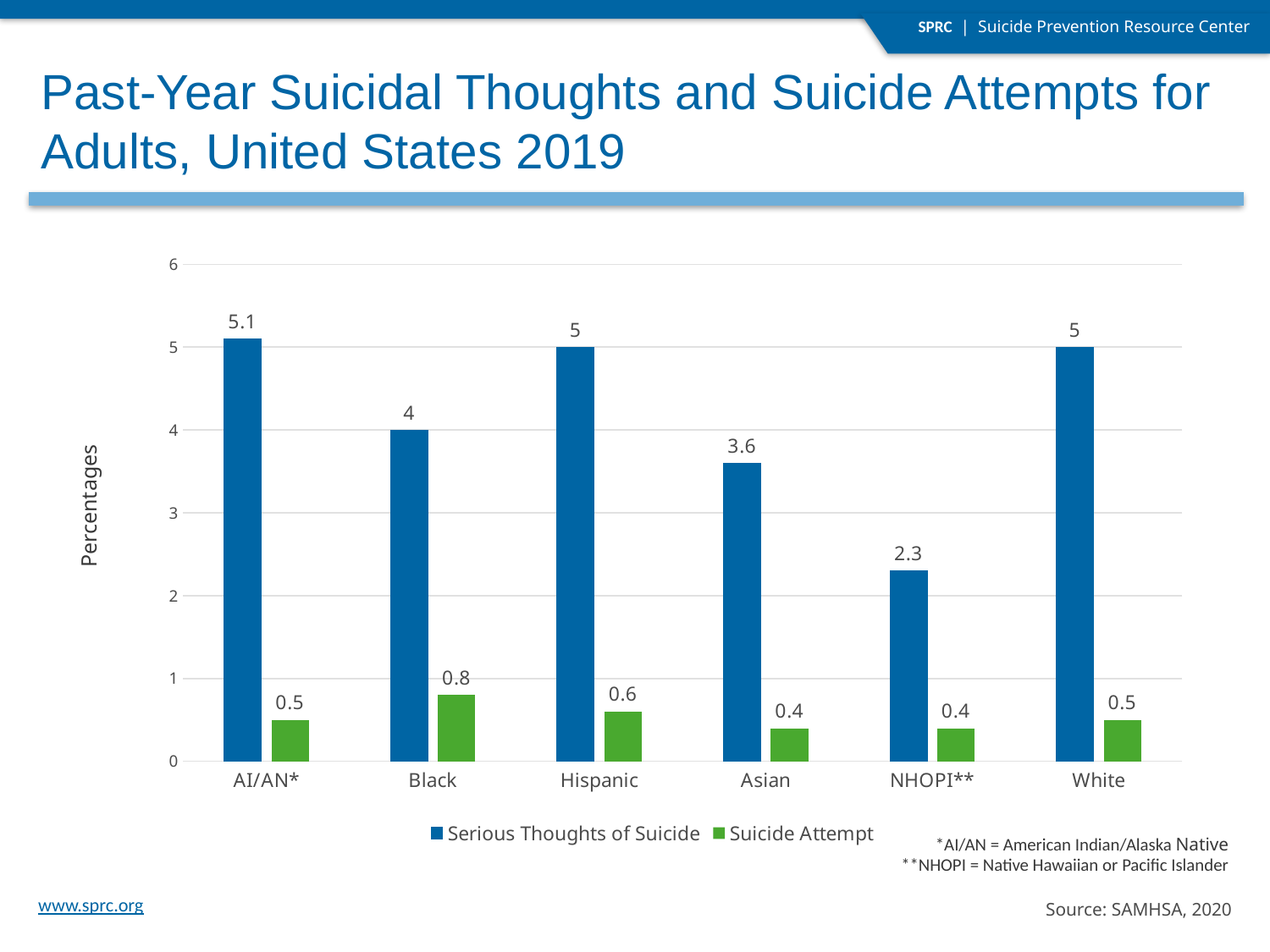
How many categories are shown on the x axis? 6 Which category has the highest value for Serious Thoughts of Suicide? AI/AN* How many series does the legend list? 2 What is the value for Suicide Attempt for Black? 0.8 Which is larger, the Serious Thoughts of Suicide value for Black or for Asian? Black What is the value for Serious Thoughts of Suicide for AI/AN*? 5.1 What is the difference between the Serious Thoughts of Suicide values for Hispanic and Asian? 1.4 Which category has the highest value for Suicide Attempt? Black Which category has the lowest value for Serious Thoughts of Suicide? NHOPI** What kind of chart is shown on the slide? Bar chart What is the label of the y axis? Percentages What is the value for Serious Thoughts of Suicide for NHOPI**? 2.3